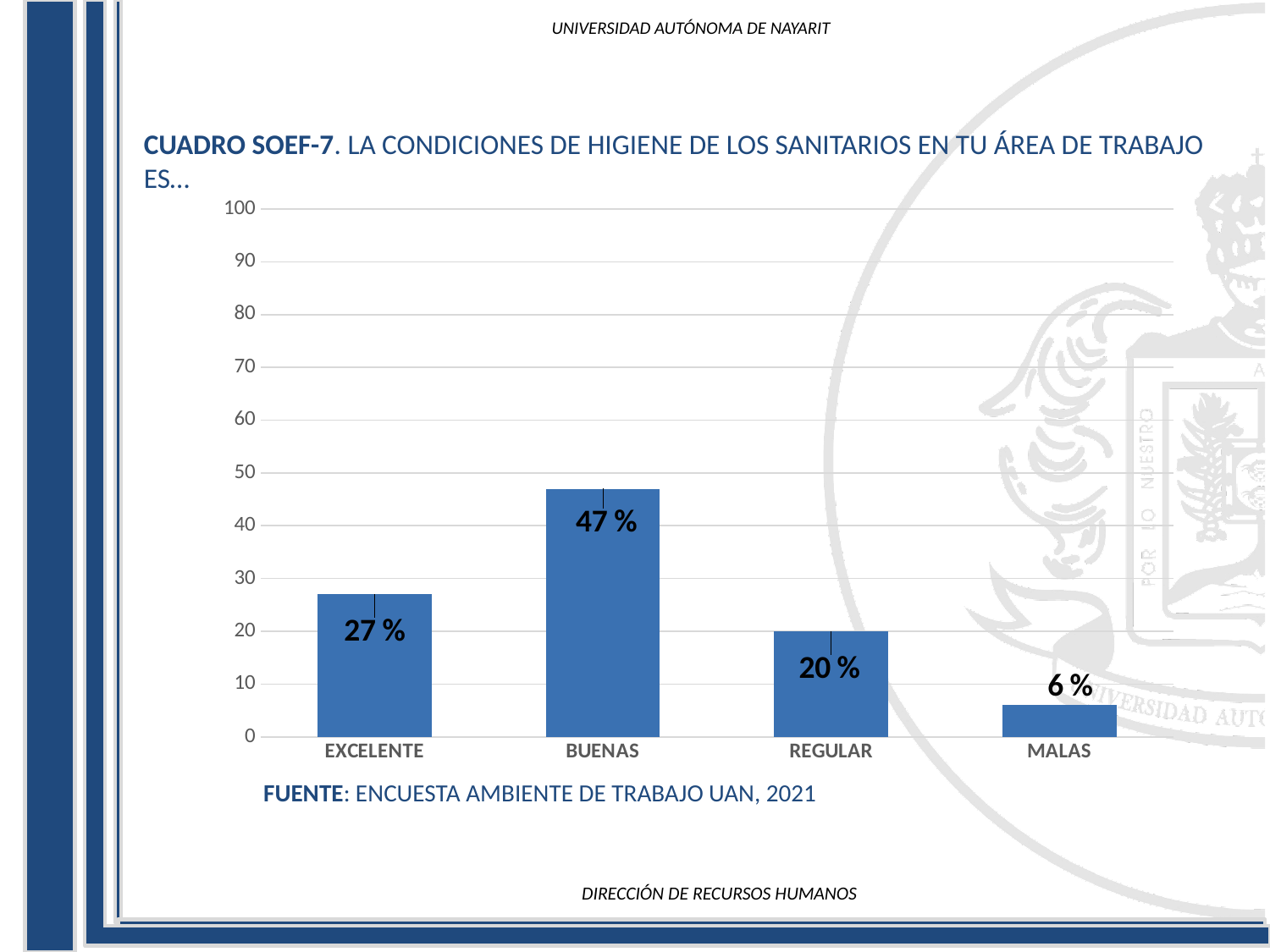
What source is cited below the chart? ENCUESTA AMBIENTE DE TRABAJO UAN, 2021 What is the difference between the values for BUENAS and EXCELENTE? 20 % What kind of chart is shown on the slide? bar chart Is the value for BUENAS greater or less than 40? greater What is the value for MALAS? 6 % What is the value for EXCELENTE? 27 % Which category has the lowest value? MALAS Which category has the highest value? BUENAS What is the value for REGULAR? 20 % How many categories are shown on the x axis? 4 What is the value for BUENAS? 47 % Which is larger, the value for EXCELENTE or the value for REGULAR? EXCELENTE